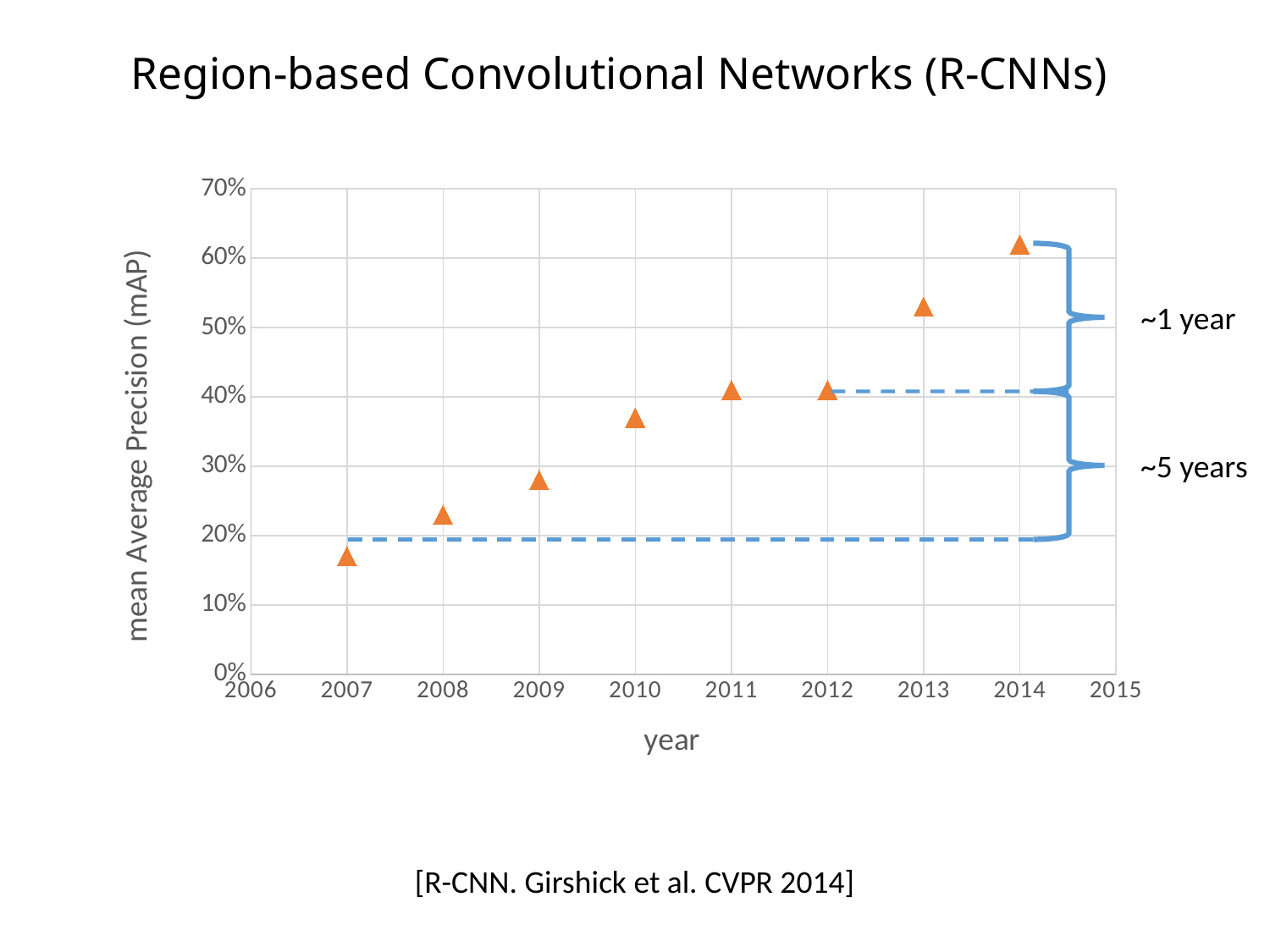
Which year has a higher mAP, 2010 or 2013? 2013 How many data points are plotted on the chart? 8 What is the label of the vertical axis? mean Average Precision (mAP) Is the value for 2014 greater or less than 60%? greater Do the mAP values generally rise or fall from 2007 to 2014? rise Is the value for 2013 greater or less than 50%? greater Is the value for 2009 greater or less than 30%? less Which year has the lowest mean Average Precision? 2007 Which year has the highest mean Average Precision? 2014 What kind of chart is shown on the slide? scatter chart